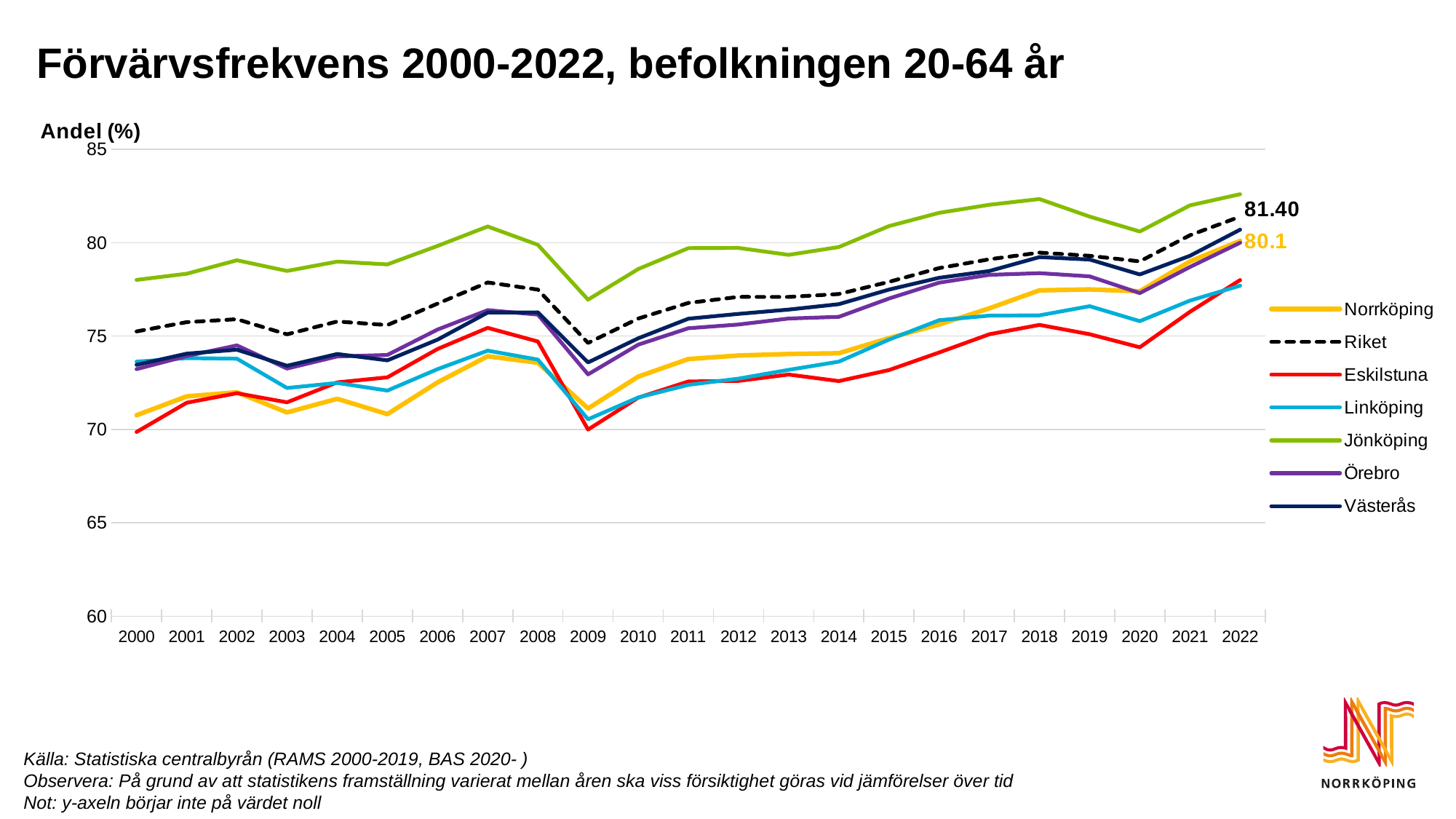
How many years are shown along the x axis? 23 In 2022, which is larger: the value for Riket or the value for Norrköping? Riket Which series has the highest value in 2022? Jönköping Which series has the lowest value in 2000? Eskilstuna What is the value for Norrköping in 2022? 80.1 Is the value for Jönköping in 2022 greater or less than 80? greater What kind of chart is shown on the slide? line chart What is the value for Riket in 2022? 81.40 Do the values for Norrköping rise or fall between 2009 and 2022? rise What is the label on the y axis? Andel (%) What is the difference between the 2022 values for Riket and Norrköping? 1.3 How many series does the legend list? 7